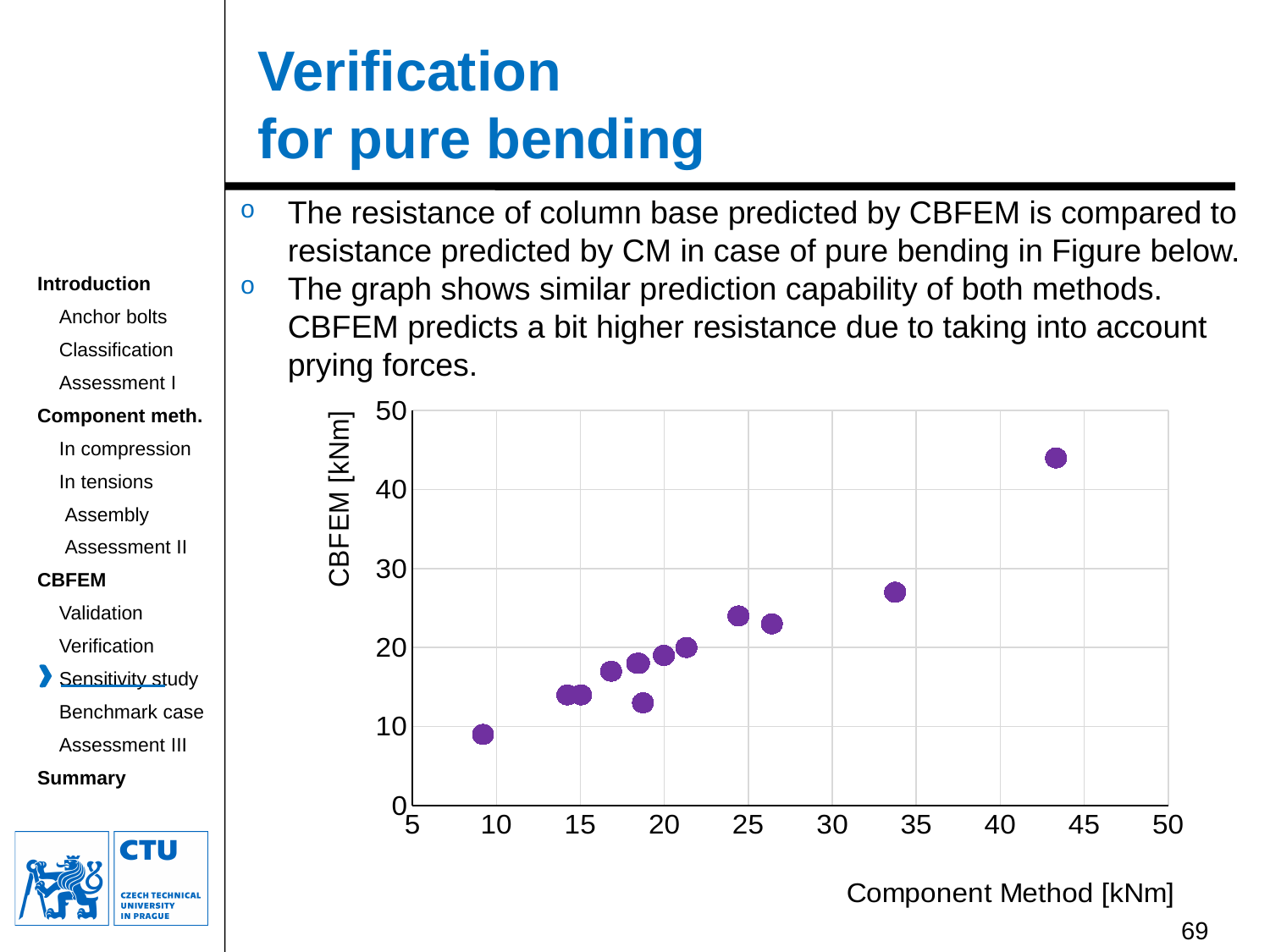
What kind of chart is shown on the slide? scatter chart Is the CBFEM value of the point with Component Method near 19 kNm that lies below the main trend greater or less than 15? less Is the CBFEM value of the point with Component Method near 34 kNm greater or less than 30? less Which point has the highest CBFEM value: the one with Component Method near 43 kNm or the one near 34 kNm? the one near 43 kNm What is the label of the vertical axis of the chart? CBFEM [kNm] Is the CBFEM value of the rightmost point (Component Method near 43 kNm) greater or less than 40? greater What is the label of the horizontal axis of the chart? Component Method [kNm] Do the CBFEM values generally rise or fall as the Component Method values increase along the x axis? rise What is the maximum value shown on the vertical axis of the chart? 50